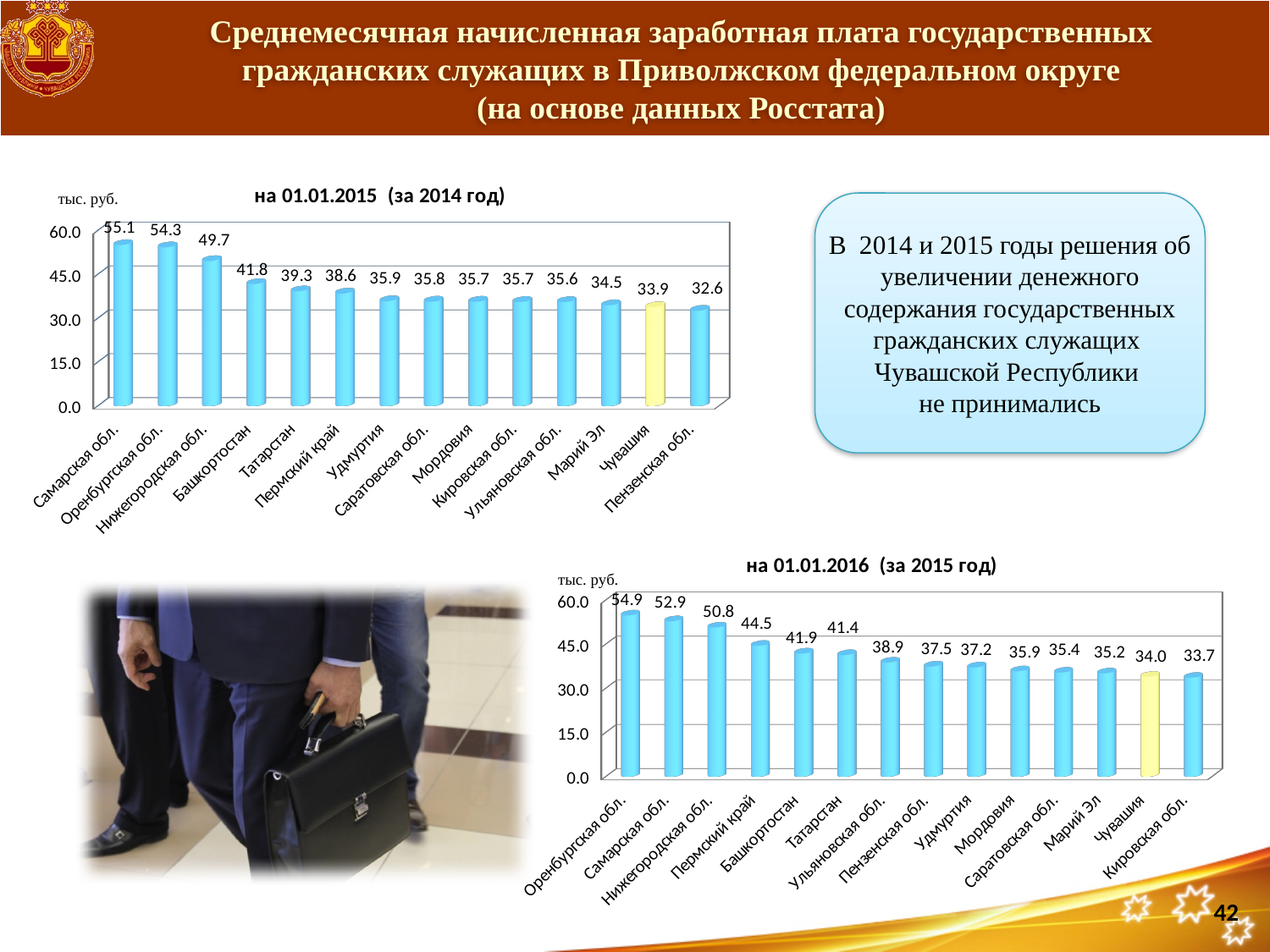
What type of chart is the bottom chart (на 01.01.2016)? Bar chart In the top chart (на 01.01.2015), what is the value for Чувашия? 33.9 In the bottom chart (на 01.01.2016), which region has the lowest value? Кировская обл. In the bottom chart (на 01.01.2016), what is the difference between Нижегородская обл. and Пермский край? 6.3 In the top chart (на 01.01.2015), do the values rise or fall from left to right? Fall In the top chart (на 01.01.2015), how many regions are shown? 14 In the bottom chart (на 01.01.2016), which region has the highest value? Оренбургская обл. In the top chart (на 01.01.2015), which region has the highest value? Самарская обл. In the top chart (на 01.01.2015), which region has the lowest value? Пензенская обл. In the bottom chart (на 01.01.2016), what is the value for Чувашия? 34.0 In the bottom chart (на 01.01.2016), which is larger: Пермский край or Башкортостан? Пермский край In the top chart (на 01.01.2015), what is the difference between Самарская обл. and Оренбургская обл.? 0.8